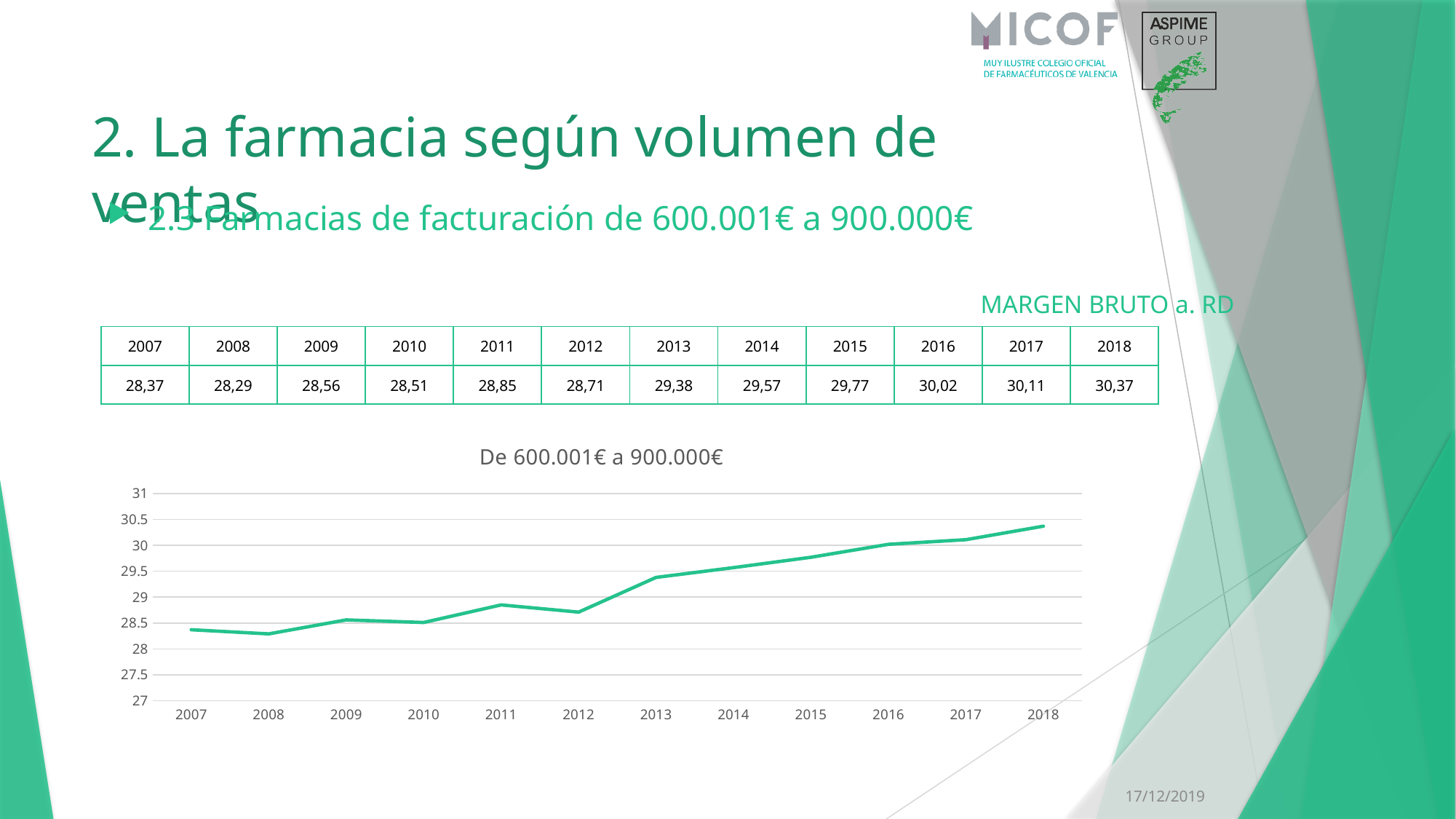
What is the value for 2018 in the chart 'De 600.001€ a 900.000€'? 30,37 What is the difference between the 2018 and 2007 values in the chart 'De 600.001€ a 900.000€'? 2,00 How many years are plotted on the x axis of the chart 'De 600.001€ a 900.000€'? 12 In the chart 'De 600.001€ a 900.000€', is the value for 2015 greater or less than 29.5? greater Which year has the lowest value in the chart 'De 600.001€ a 900.000€'? 2008 In the chart 'De 600.001€ a 900.000€', which is larger, the value for 2011 or the value for 2012? 2011 Do the values in the chart 'De 600.001€ a 900.000€' generally rise or fall from 2007 to 2018? rise What kind of chart is shown on the slide? line chart Which year has the highest value in the chart 'De 600.001€ a 900.000€'? 2018 What is the value for 2007 in the chart 'De 600.001€ a 900.000€'? 28,37 What is the value for 2013 in the chart 'De 600.001€ a 900.000€'? 29,38 What is the difference between the 2013 and 2012 values in the chart 'De 600.001€ a 900.000€'? 0,67